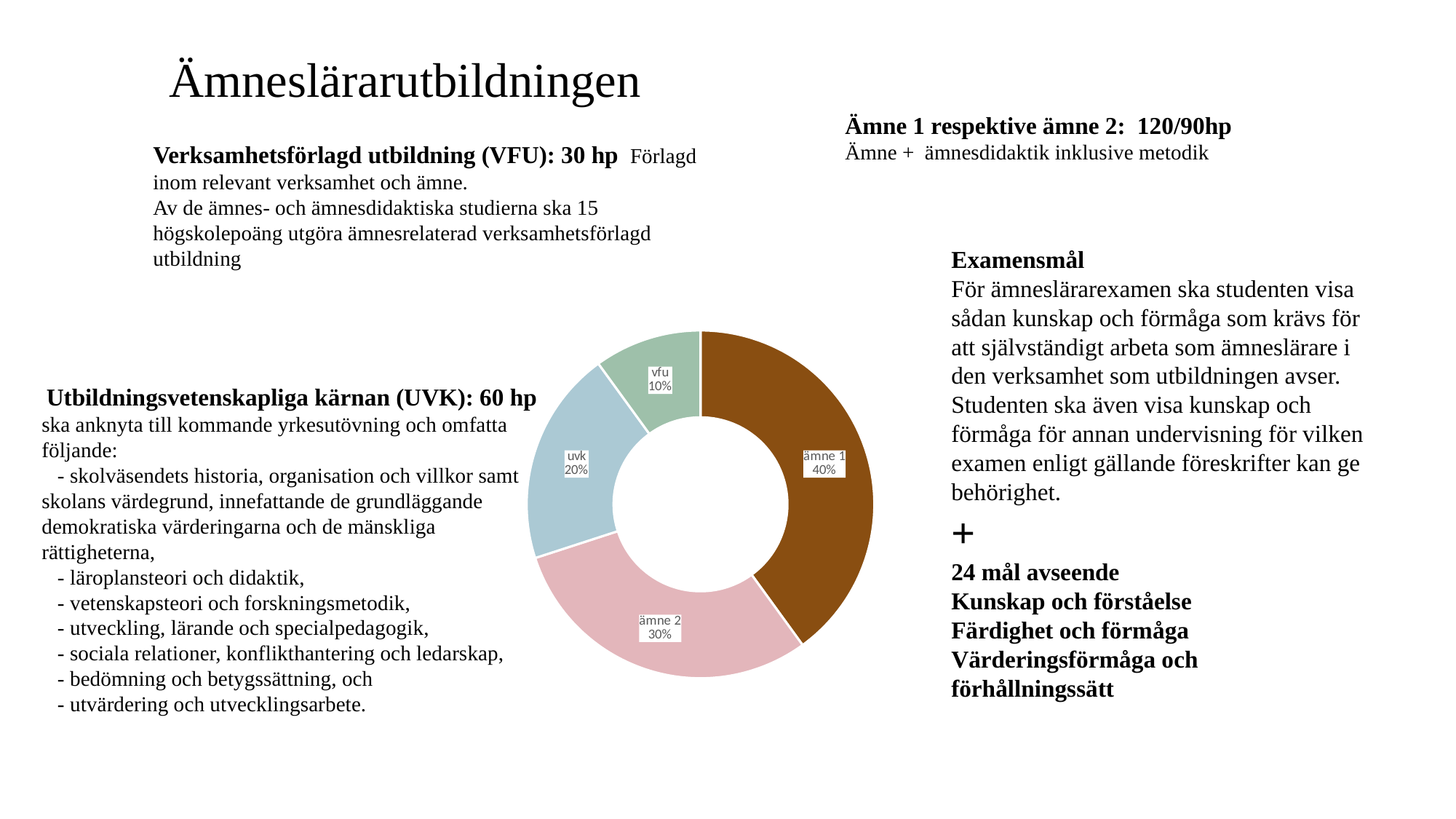
What is the difference in percentage points between ämne 1 and ämne 2 in the doughnut chart? 10 How many segments does the doughnut chart have? 4 Which segment of the doughnut chart is the largest? ämne 1 What colour is the ämne 1 segment in the doughnut chart? Brown What share of the doughnut chart does ämne 2 represent? 30% What is the combined share of ämne 1 and ämne 2 in the doughnut chart? 70% Which is larger in the doughnut chart, uvk or vfu? uvk Which segment of the doughnut chart is the smallest? vfu What share of the doughnut chart does ämne 1 represent? 40% What share of the doughnut chart does vfu represent? 10% What kind of chart is shown on the slide? Doughnut chart